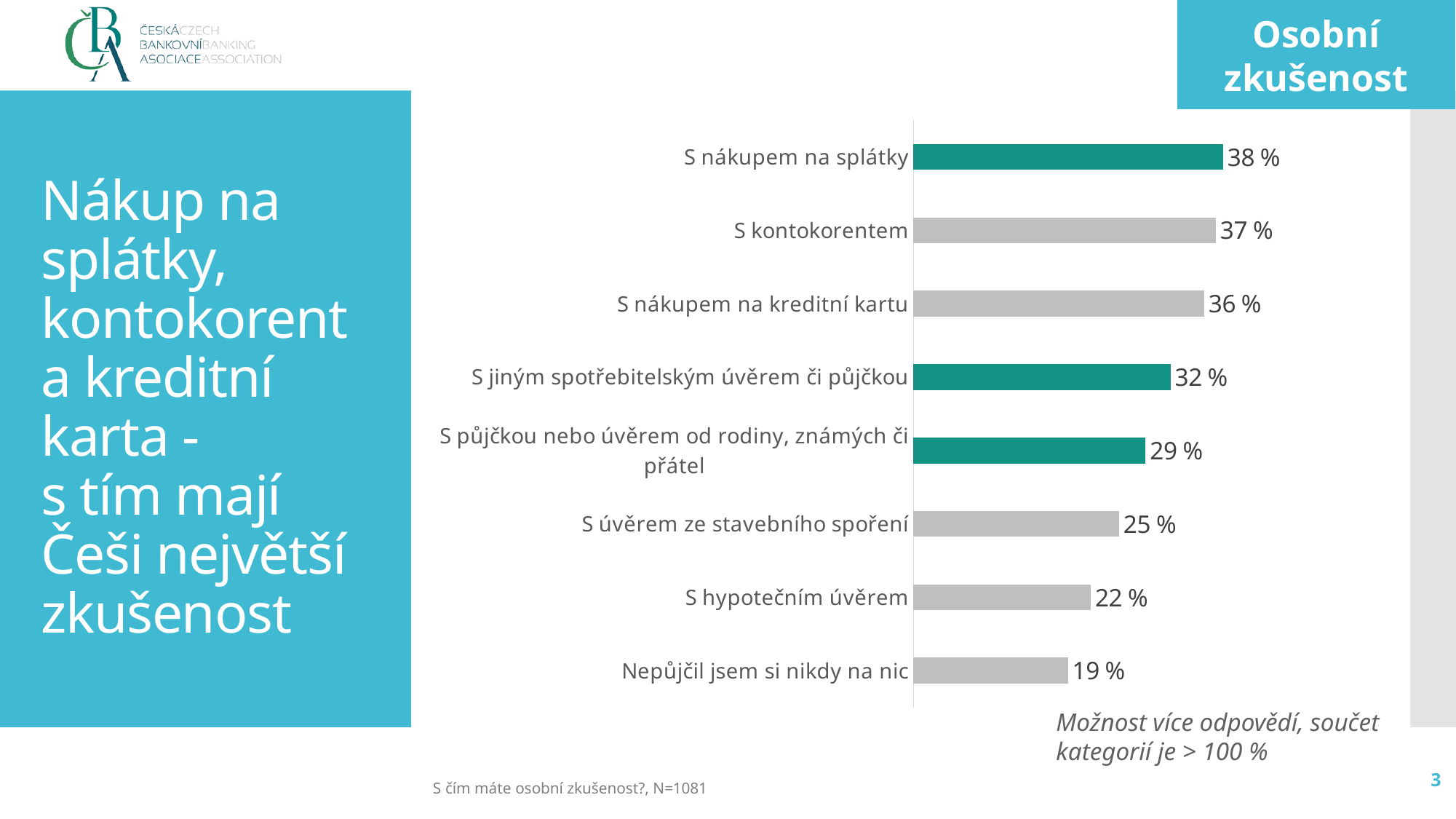
What is the value for "S hypotečním úvěrem"? 22 % Which category has the highest value? S nákupem na splátky What kind of chart is shown on the slide? Bar chart Which category has the lowest value? Nepůjčil jsem si nikdy na nic What is the difference between the values for "S nákupem na splátky" and "Nepůjčil jsem si nikdy na nic"? 19 % Which is larger: the value for "S jiným spotřebitelským úvěrem či půjčkou" or the value for "S nákupem na kreditní kartu"? S nákupem na kreditní kartu What is the value for "S nákupem na splátky"? 38 % How many categories are shown in the chart? 8 What is the difference between the values for "S kontokorentem" and "S úvěrem ze stavebního spoření"? 12 % What is the value for "S půjčkou nebo úvěrem od rodiny, známých či přátel"? 29 % What is the value for "S úvěrem ze stavebního spoření"? 25 % How many bars in the chart are coloured teal (green) rather than grey? 3